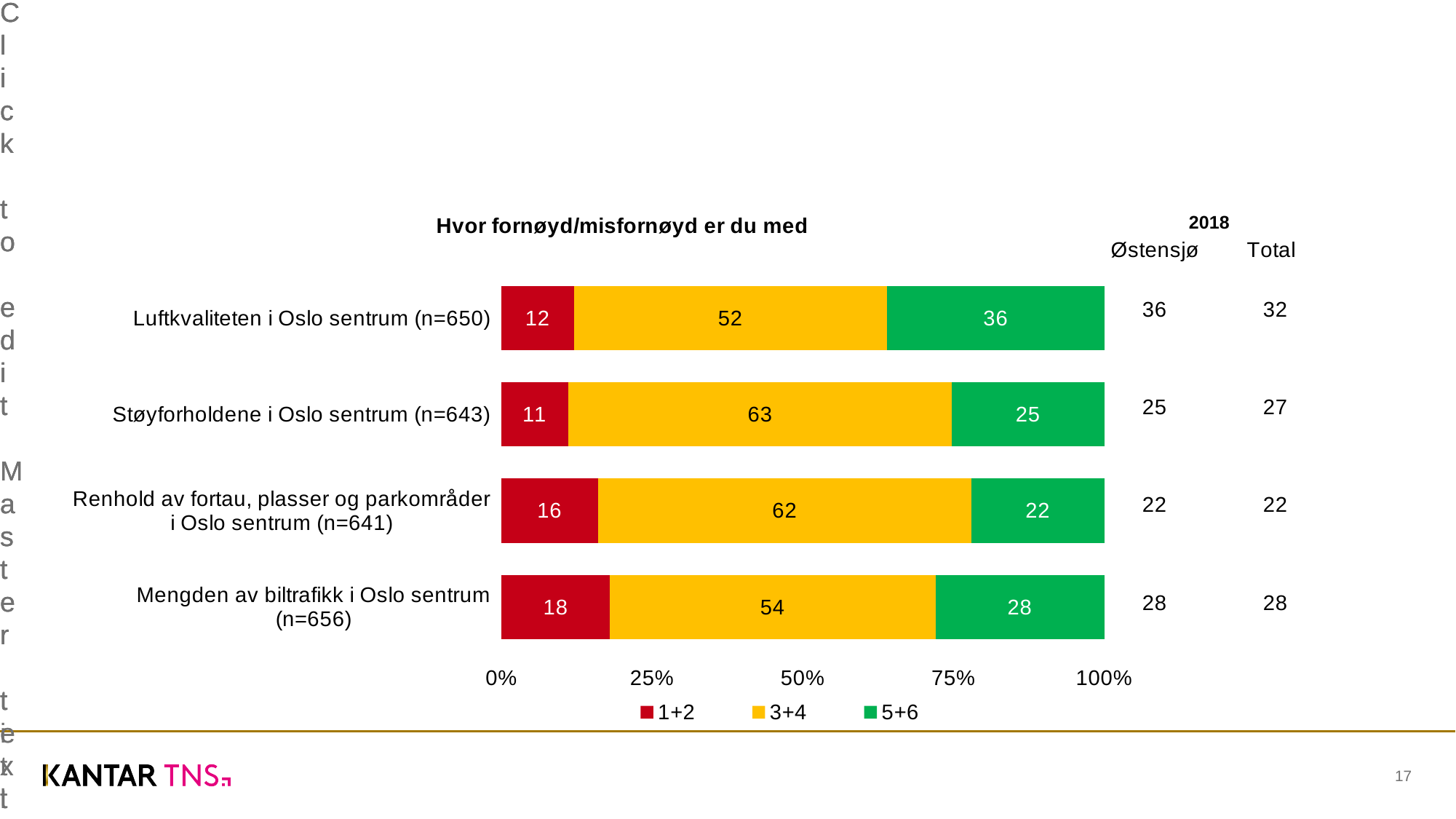
How many series does the legend list? 3 What is the title of the chart? Hvor fornøyd/misfornøyd er du med What is the total of the stacked bar for Støyforholdene i Oslo sentrum (n=643)? 99 What kind of chart is shown on the slide? Stacked bar chart What is the value of the 3+4 series for Støyforholdene i Oslo sentrum (n=643)? 63 What is the value of the 1+2 series for Luftkvaliteten i Oslo sentrum (n=650)? 12 Which is larger: the 1+2 value for Mengden av biltrafikk i Oslo sentrum (n=656) or for Renhold av fortau, plasser og parkområder i Oslo sentrum (n=641)? Mengden av biltrafikk i Oslo sentrum (n=656) Which category has the lowest value for the 1+2 series? Støyforholdene i Oslo sentrum (n=643) What is the value of the 5+6 series for Mengden av biltrafikk i Oslo sentrum (n=656)? 28 Which category has the highest value for the 5+6 series? Luftkvaliteten i Oslo sentrum (n=650) How many categories are shown in the chart? 4 What is the difference between the 3+4 values for Renhold av fortau, plasser og parkområder i Oslo sentrum (n=641) and Luftkvaliteten i Oslo sentrum (n=650)? 10